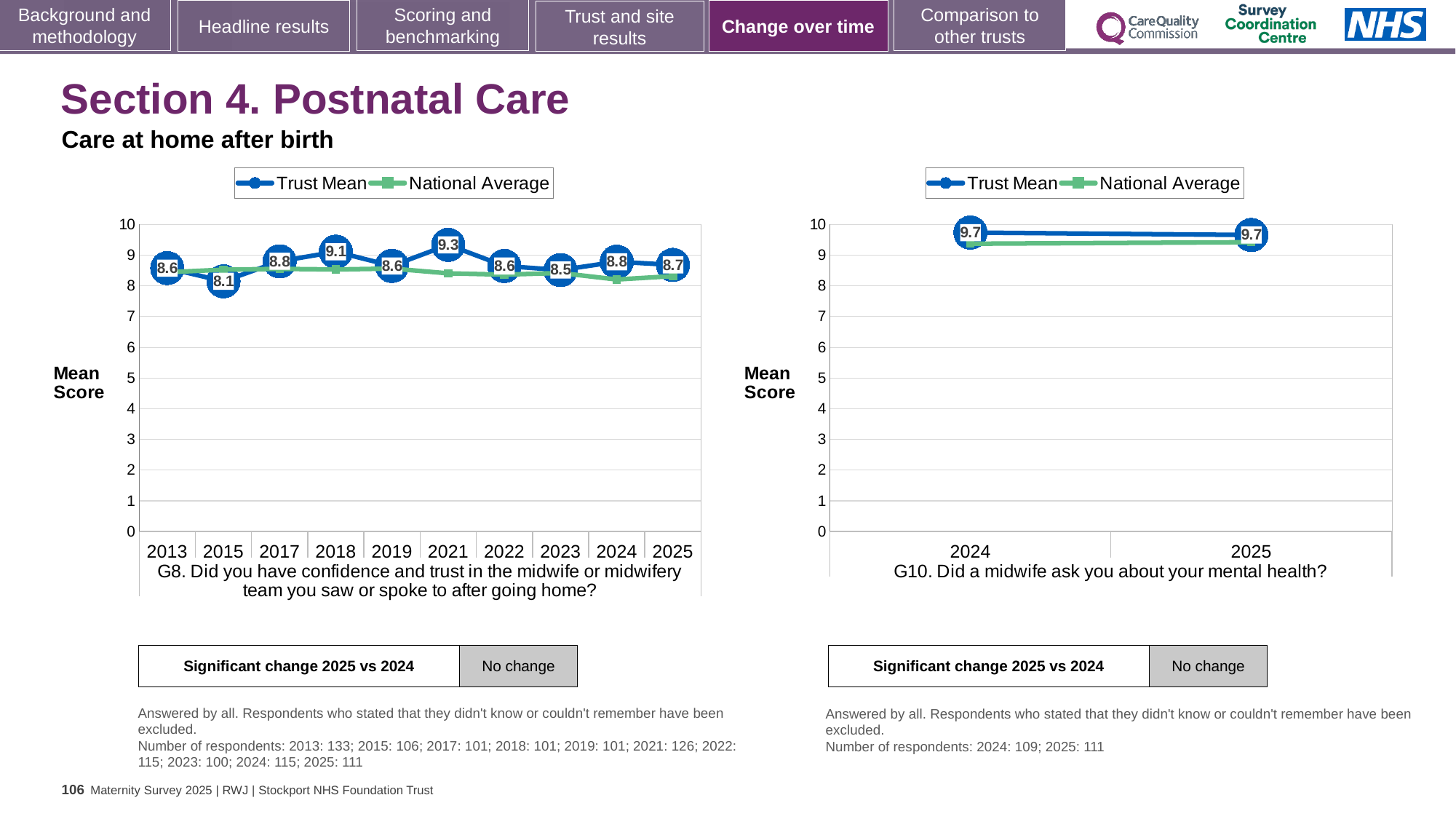
In the G8 chart on the left, what is the Trust Mean score for 2021? 9.3 In the G8 chart on the left, which year has the lowest Trust Mean score? 2015 What kind of chart is the G10 chart on the right? Line chart In the G10 chart on the right, what is the Trust Mean score for 2025? 9.7 How many years are plotted on the x axis of the G8 chart on the left? 10 In the G8 chart on the left, is the Trust Mean score higher in 2018 or in 2019? 2018 In the G8 chart on the left, which year has the highest Trust Mean score? 2021 In the G8 chart on the left, what is the Trust Mean score for 2025? 8.7 In the G8 chart on the left, what is the difference between the Trust Mean scores for 2021 and 2015? 1.2 In the G8 chart on the left, what is the Trust Mean score for 2015? 8.1 In the G8 chart on the left, is the National Average value for 2013 greater or less than 9? less How many series does the legend of the G10 chart on the right list? 2